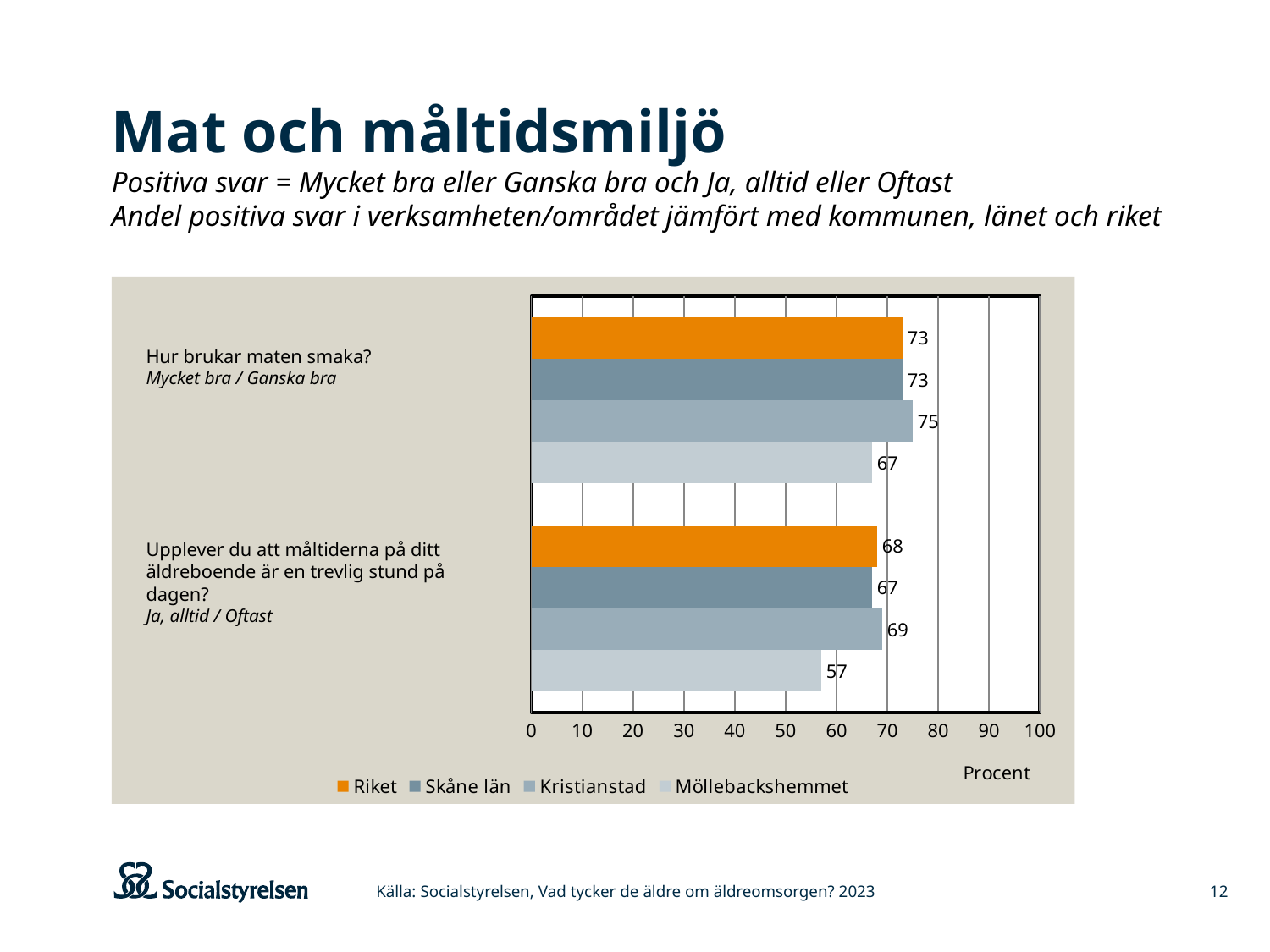
What is the label of the x axis? Procent Which series has the highest value for the question "Hur brukar maten smaka?"? Kristianstad What type of chart is shown on the slide? Bar chart What is the difference between the Riket and Möllebackshemmet values for the question "Upplever du att måltiderna på ditt äldreboende är en trevlig stund på dagen?"? 11 How many series does the legend list? 4 What is the difference between the Kristianstad and Möllebackshemmet values for the question "Hur brukar maten smaka?"? 8 What is the value for Kristianstad for the question "Hur brukar maten smaka?"? 75 Which is larger for Möllebackshemmet: the value for "Hur brukar maten smaka?" or the value for "Upplever du att måltiderna på ditt äldreboende är en trevlig stund på dagen?"? Hur brukar maten smaka? What is the value for Riket for the question "Upplever du att måltiderna på ditt äldreboende är en trevlig stund på dagen?"? 68 What is the value for Möllebackshemmet for the question "Upplever du att måltiderna på ditt äldreboende är en trevlig stund på dagen?"? 57 Which series has the lowest value for the question "Upplever du att måltiderna på ditt äldreboende är en trevlig stund på dagen?"? Möllebackshemmet What is the value for Skåne län for the question "Hur brukar maten smaka?"? 73